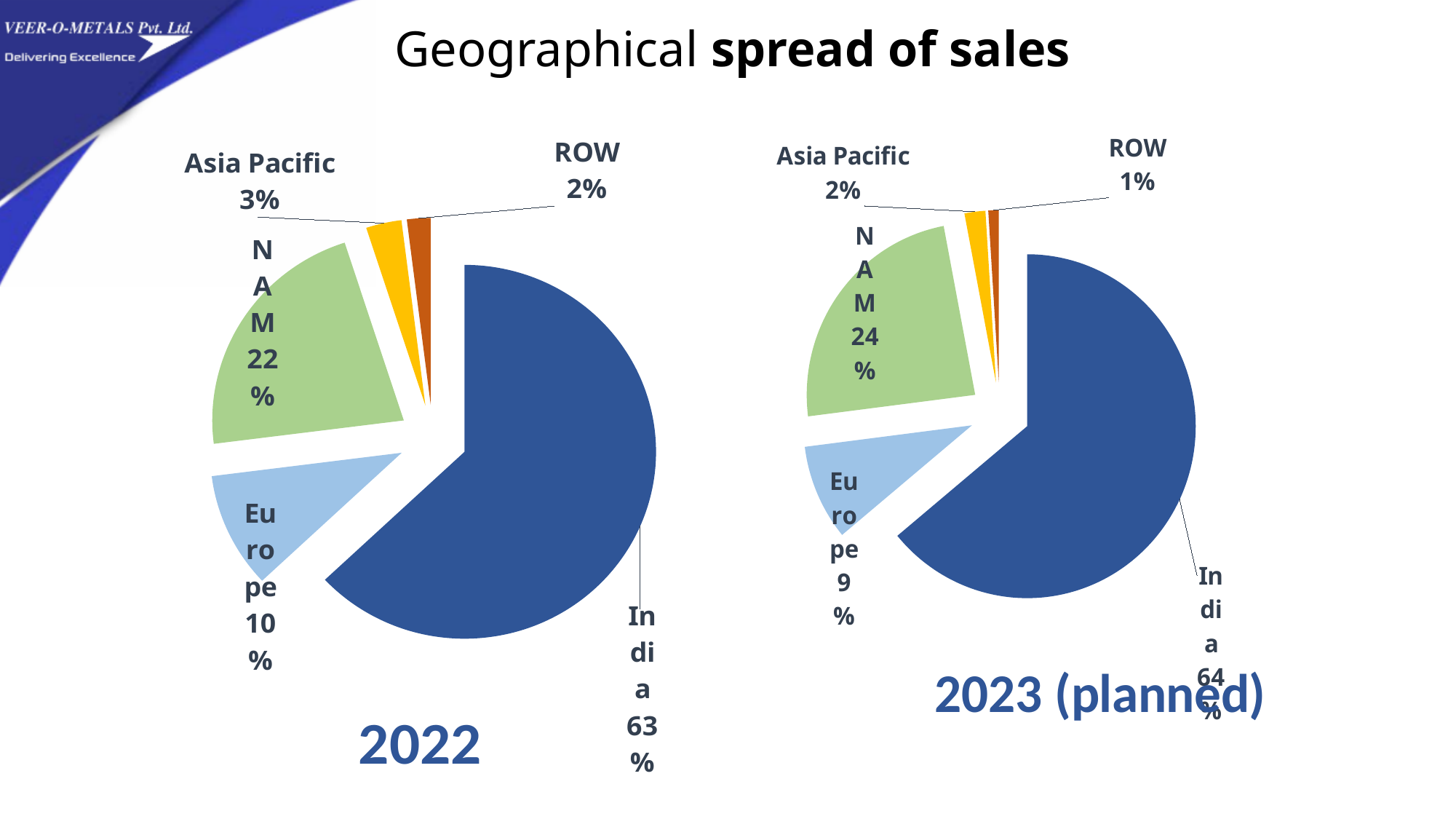
What type of chart is used on this slide? Pie chart In the 2023 (planned) pie chart, which is larger, Asia Pacific or Europe? Europe In the 2022 pie chart, which region has the largest share? India In the 2022 pie chart, what is the difference between the NAM share and the Europe share? 12% In the 2022 pie chart, what share of sales does India account for? 63% What is the title of the slide? Geographical spread of sales In the 2023 (planned) pie chart, which region has the smallest share? ROW How many regions are shown in the 2022 pie chart? 5 In the 2022 pie chart, what is the value for Europe? 10% In the 2023 (planned) pie chart, what is the value for ROW? 1% In the 2023 (planned) pie chart, what colour is the India slice? Dark blue In the 2023 (planned) pie chart, what share of sales does NAM account for? 24%